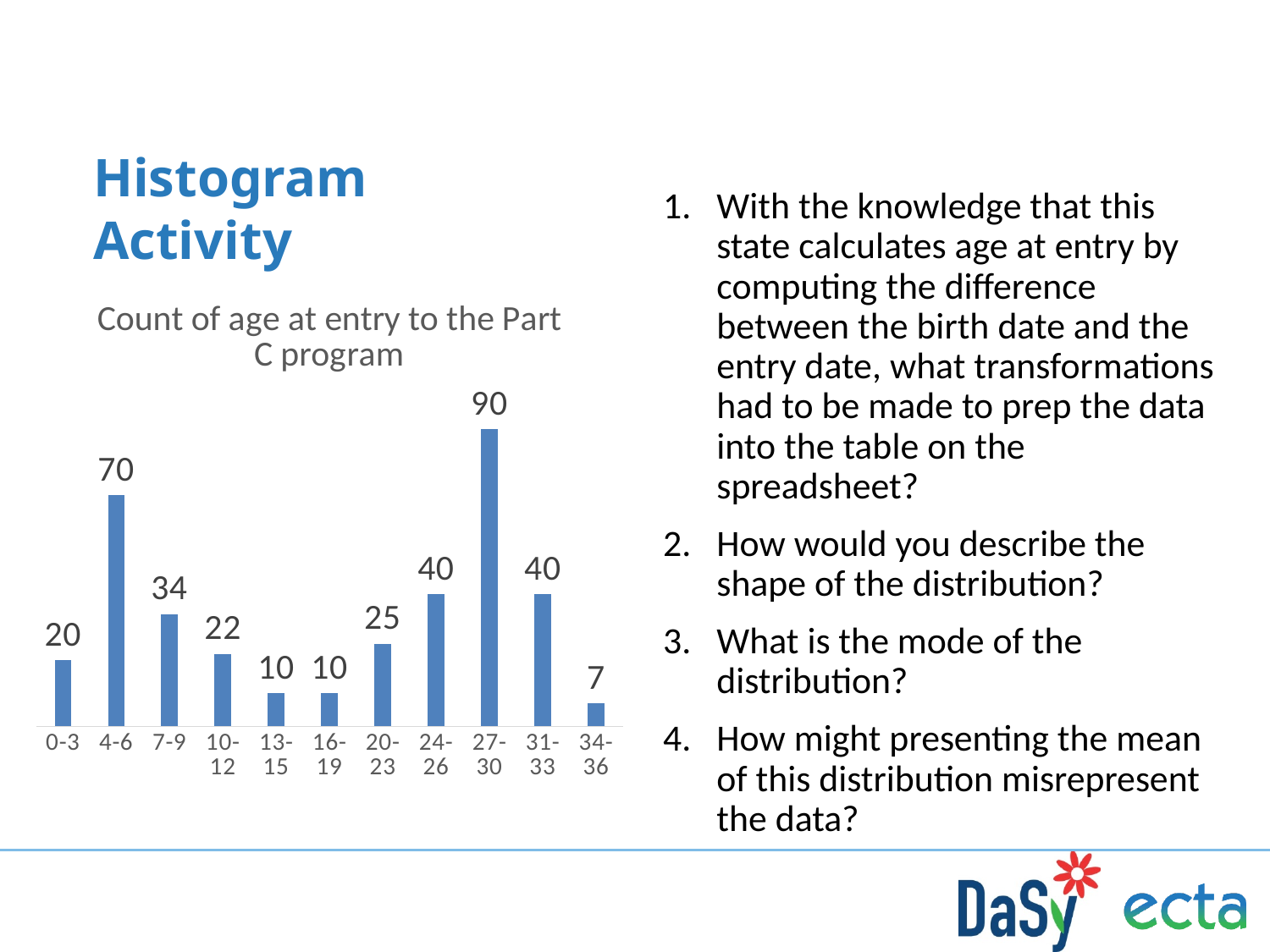
What is the difference between the counts for 7-9 and 10-12? 12 What is the count for the 4-6 age category? 70 How many age categories are shown on the x axis? 11 What is the title of the chart? Count of age at entry to the Part C program Which age category has the lowest count? 34-36 What is the difference between the counts for 27-30 and 4-6? 20 Which has a larger count, 20-23 or 24-26? 24-26 Do the counts rise or fall from the 13-15 category to the 27-30 category? rise What is the count for the 27-30 age category? 90 Which age category has the highest count? 27-30 What kind of chart is shown on the slide? bar chart What is the count for the 34-36 age category? 7